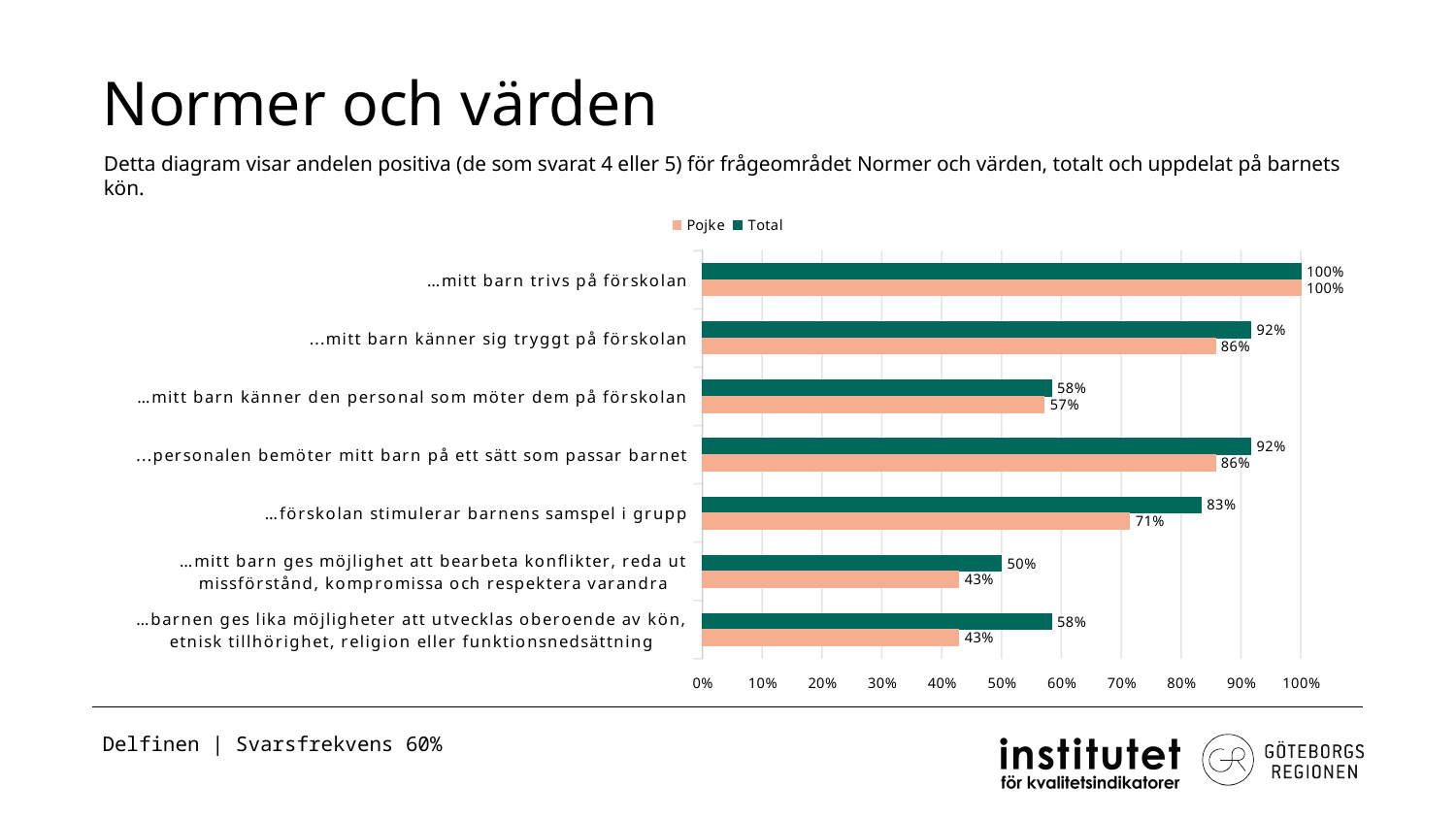
What type of chart is shown on the slide? Bar chart What is the Pojke value for "…mitt barn känner den personal som möter dem på förskolan"? 57% Which series is shown in dark green in the legend? Total How many categories are shown in the chart? 7 What is the difference between the Total and Pojke values for "…förskolan stimulerar barnens samspel i grupp"? 12% Which is larger for "...mitt barn känner sig tryggt på förskolan": the Total value or the Pojke value? Total What is the difference between the Total and Pojke values for "…barnen ges lika möjligheter att utvecklas oberoende av kön, etnisk tillhörighet, religion eller funktionsnedsättning"? 15% What is the Total value for "…förskolan stimulerar barnens samspel i grupp"? 83% How many series does the legend list? 2 Which category has the highest Pojke value? …mitt barn trivs på förskolan What is the Pojke value for "…barnen ges lika möjligheter att utvecklas oberoende av kön, etnisk tillhörighet, religion eller funktionsnedsättning"? 43% Which category has the lowest Total value? …mitt barn ges möjlighet att bearbeta konflikter, reda ut missförstånd, kompromissa och respektera varandra